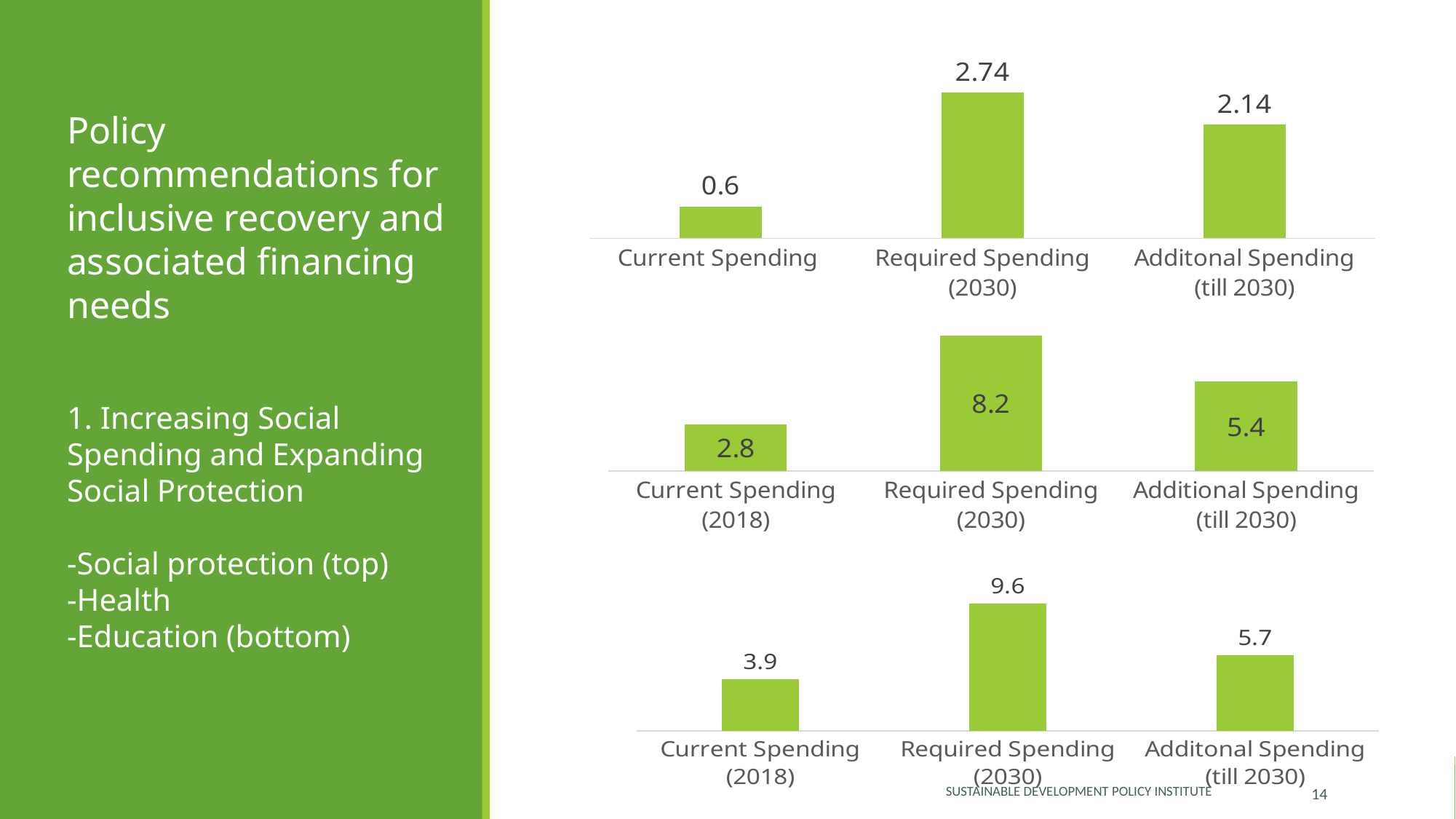
In the middle chart (health), which category has the highest value? Required Spending (2030) What type of chart is the bottom chart (education)? Bar chart In the top chart (social protection), what is the value for Required Spending (2030)? 2.74 In the middle chart (health), which is larger: Current Spending (2018) or Additional Spending (till 2030)? Additional Spending (till 2030) In the bottom chart (education), what is the value for Required Spending (2030)? 9.6 How many charts are shown on the slide? 3 In the bottom chart (education), which category has the lowest value? Current Spending (2018) In the top chart (social protection), what is the value for Current Spending? 0.6 How many bars are shown in the top chart (social protection)? 3 In the bottom chart (education), what is the difference between Required Spending (2030) and Additional Spending (till 2030)? 3.9 In the middle chart (health), what is the value for Additional Spending (till 2030)? 5.4 In the top chart (social protection), what is the difference between Required Spending (2030) and Current Spending? 2.14